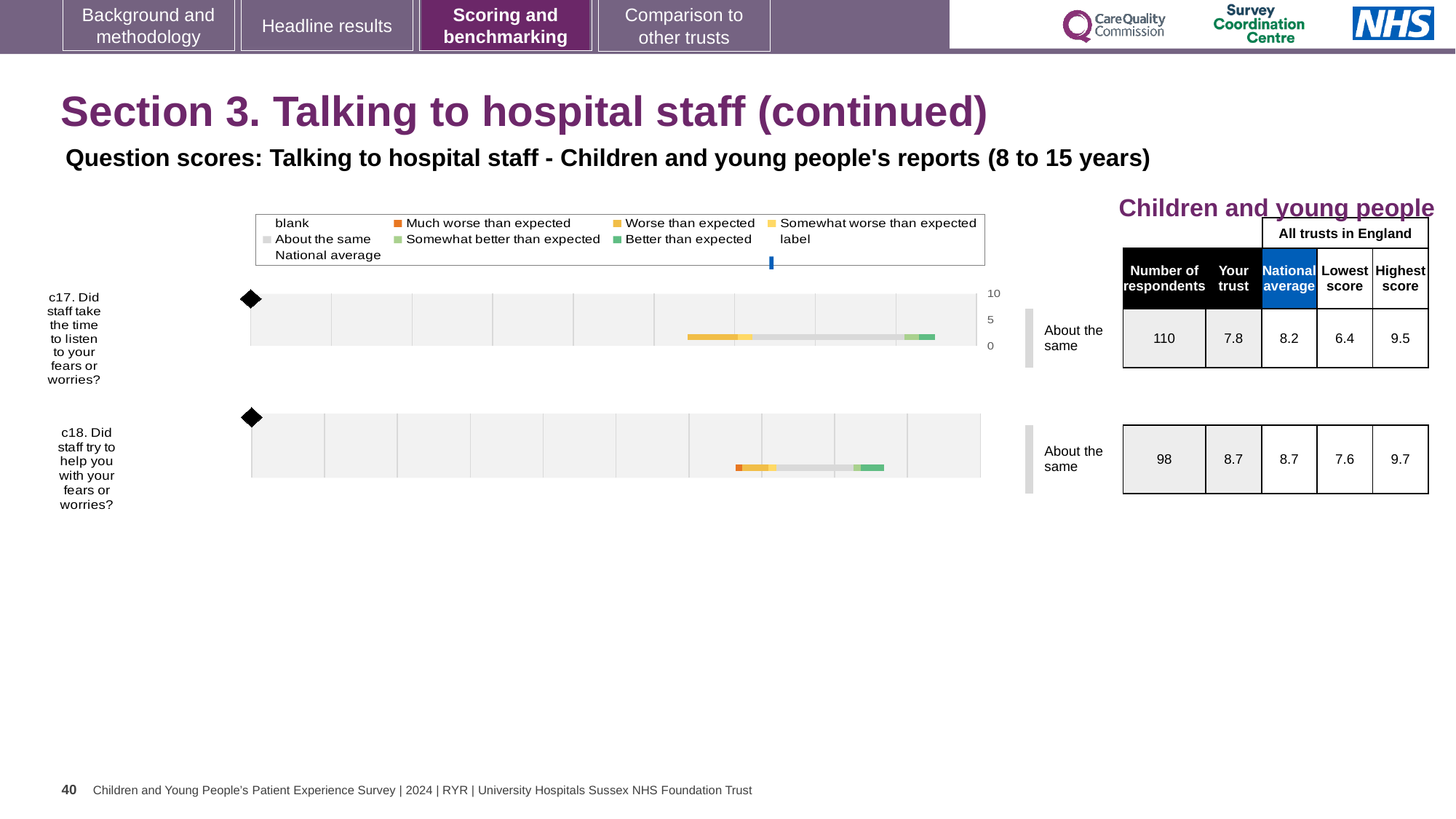
What is the difference between the 'Your trust' scores for c18 and c17? 0.9 What is the maximum value shown on the score axis of the charts? 10 What is the 'Your trust' score for c17 (Did staff take the time to listen to your fears or worries?)? 7.8 Which question has the higher 'Your trust' score, c17 or c18? c18 What is the difference between the highest and lowest scores across all trusts for c17? 3.1 What is the highest score among all trusts in England for c18? 9.7 What is the national average score for c18 (Did staff try to help you with your fears or worries?)? 8.7 How many survey questions are plotted on the slide? 2 How many respondents answered question c17? 110 What benchmark category is shown for c17? About the same What kind of chart is used to show the question scores for c17 and c18? bar chart Which colour in the legend represents 'Much worse than expected'? orange